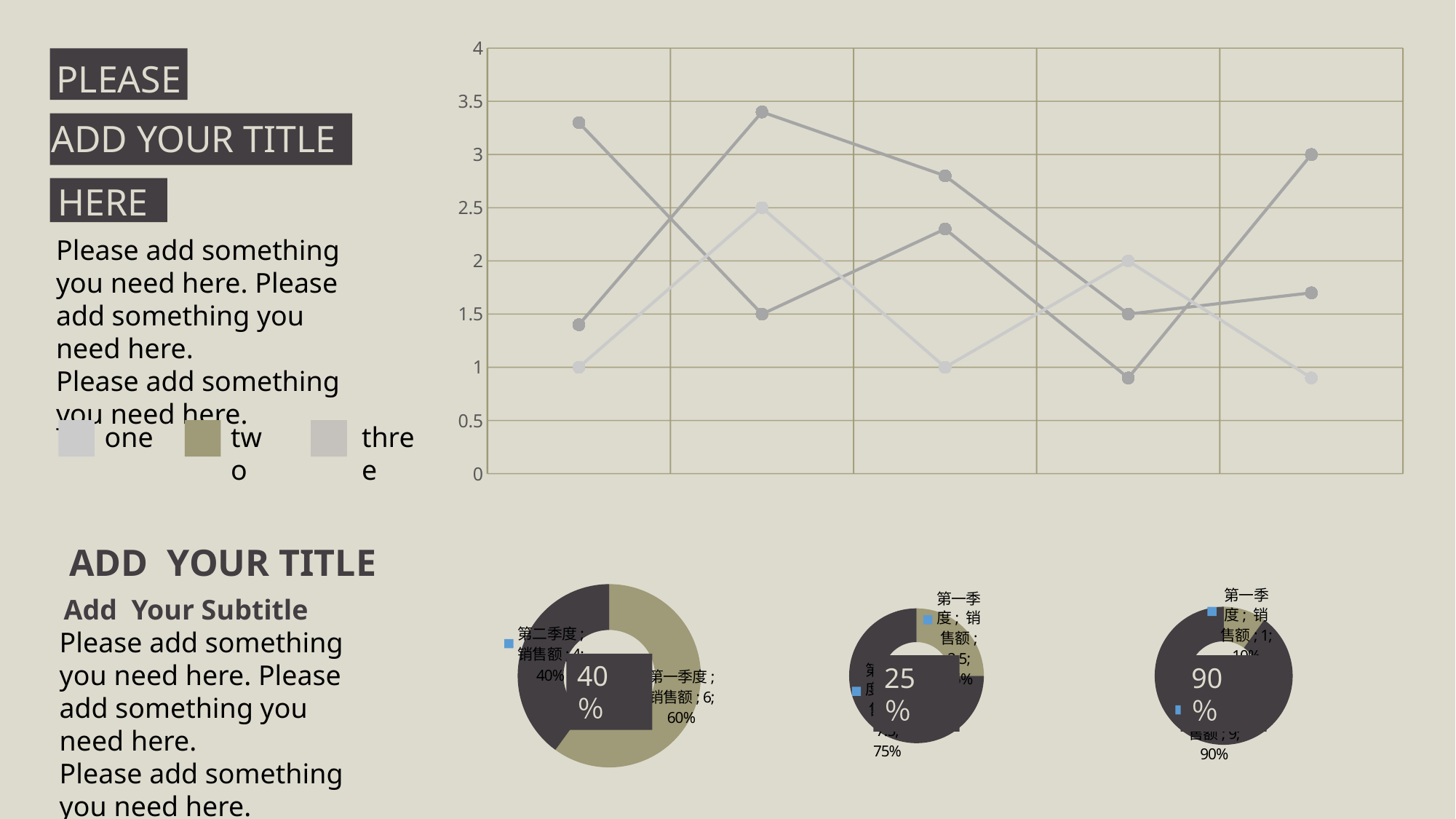
What kind of chart are the three small charts at the bottom of the slide? Doughnut chart How many lines are plotted in the top line chart? 3 In the bottom-left doughnut chart, which is larger, 第一季度 or 第二季度? 第一季度 What kind of chart is the large chart at the top of the slide? Line chart How many data points does each line in the top line chart have? 5 In the bottom-middle doughnut chart, what is the 销售额 value for 第一季度? 2.5 In the bottom-left doughnut chart, what is the 销售额 value for 第二季度? 4 What percentage is printed in the centre of the bottom-left doughnut chart? 40% What is the highest value shown on the y axis of the top line chart? 4 In the bottom-left doughnut chart, what share does 第一季度 have? 60% In the bottom-middle doughnut chart, what share does 第一季度 have? 25% In the bottom-right doughnut chart, what share does 第一季度 have? 10%